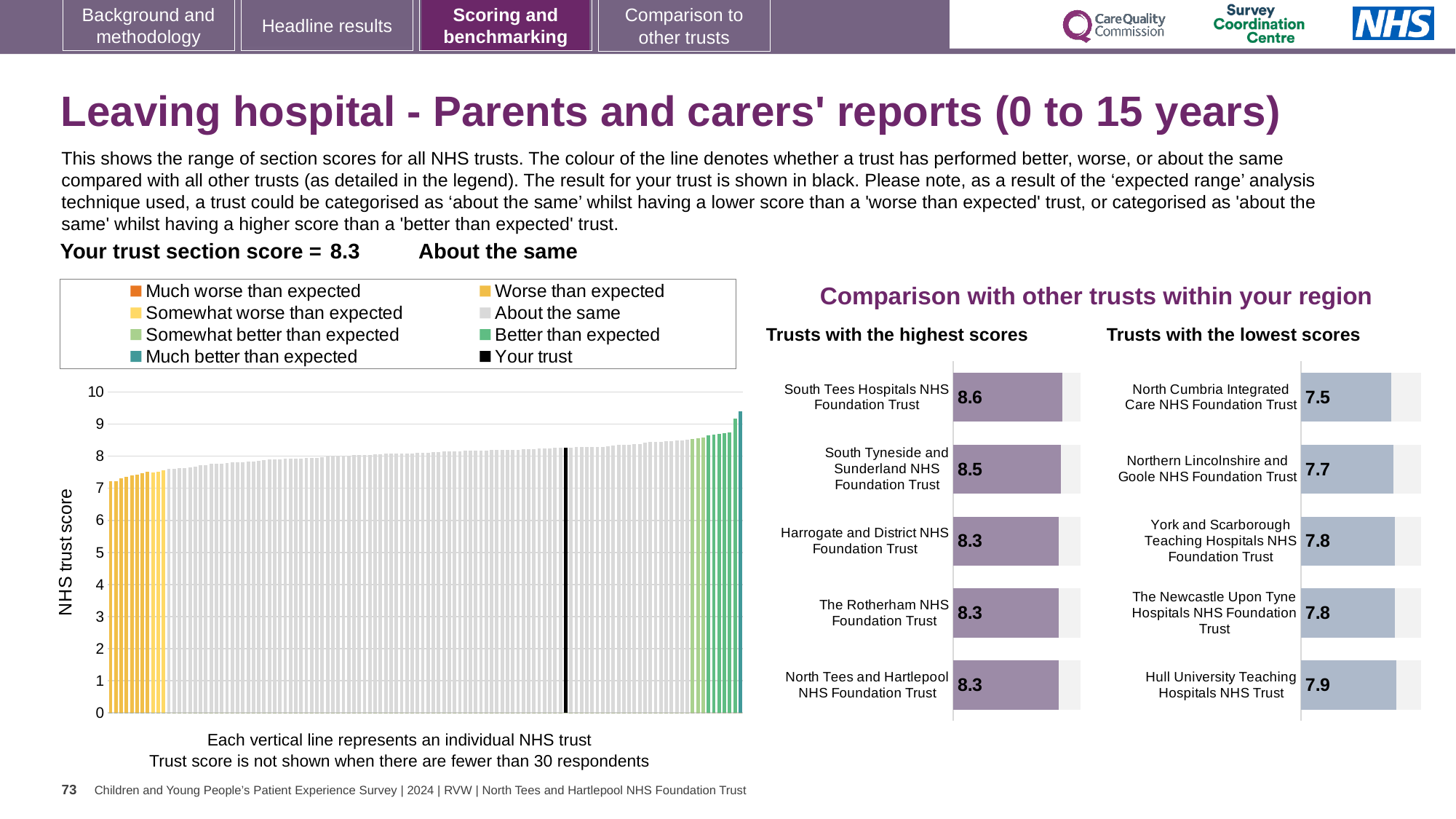
What kind of chart is the main 'NHS trust score' chart on the left? bar chart In the 'Trusts with the lowest scores' chart, which trust has the lowest score? North Cumbria Integrated Care NHS Foundation Trust In the 'Trusts with the highest scores' chart, what is the score for South Tees Hospitals NHS Foundation Trust? 8.6 In the 'Trusts with the highest scores' chart, what is the difference between the scores of South Tees Hospitals NHS Foundation Trust and South Tyneside and Sunderland NHS Foundation Trust? 0.1 How many entries does the legend of the main 'NHS trust score' chart list? 8 In the 'Trusts with the lowest scores' chart, what is the difference between the scores of Hull University Teaching Hospitals NHS Trust and North Cumbria Integrated Care NHS Foundation Trust? 0.4 In the main 'NHS trust score' chart on the left, do the bar values rise or fall from left to right? rise How many trusts are listed in the 'Trusts with the highest scores' chart? 5 In the 'Trusts with the highest scores' chart, which trust has the highest score? South Tees Hospitals NHS Foundation Trust In the 'Trusts with the lowest scores' chart, what is the score for North Cumbria Integrated Care NHS Foundation Trust? 7.5 In the 'Trusts with the lowest scores' chart, which has the larger score: Northern Lincolnshire and Goole NHS Foundation Trust or Hull University Teaching Hospitals NHS Trust? Hull University Teaching Hospitals NHS Trust In the main 'NHS trust score' chart on the left, is the value for the tallest bar greater or less than 9? greater